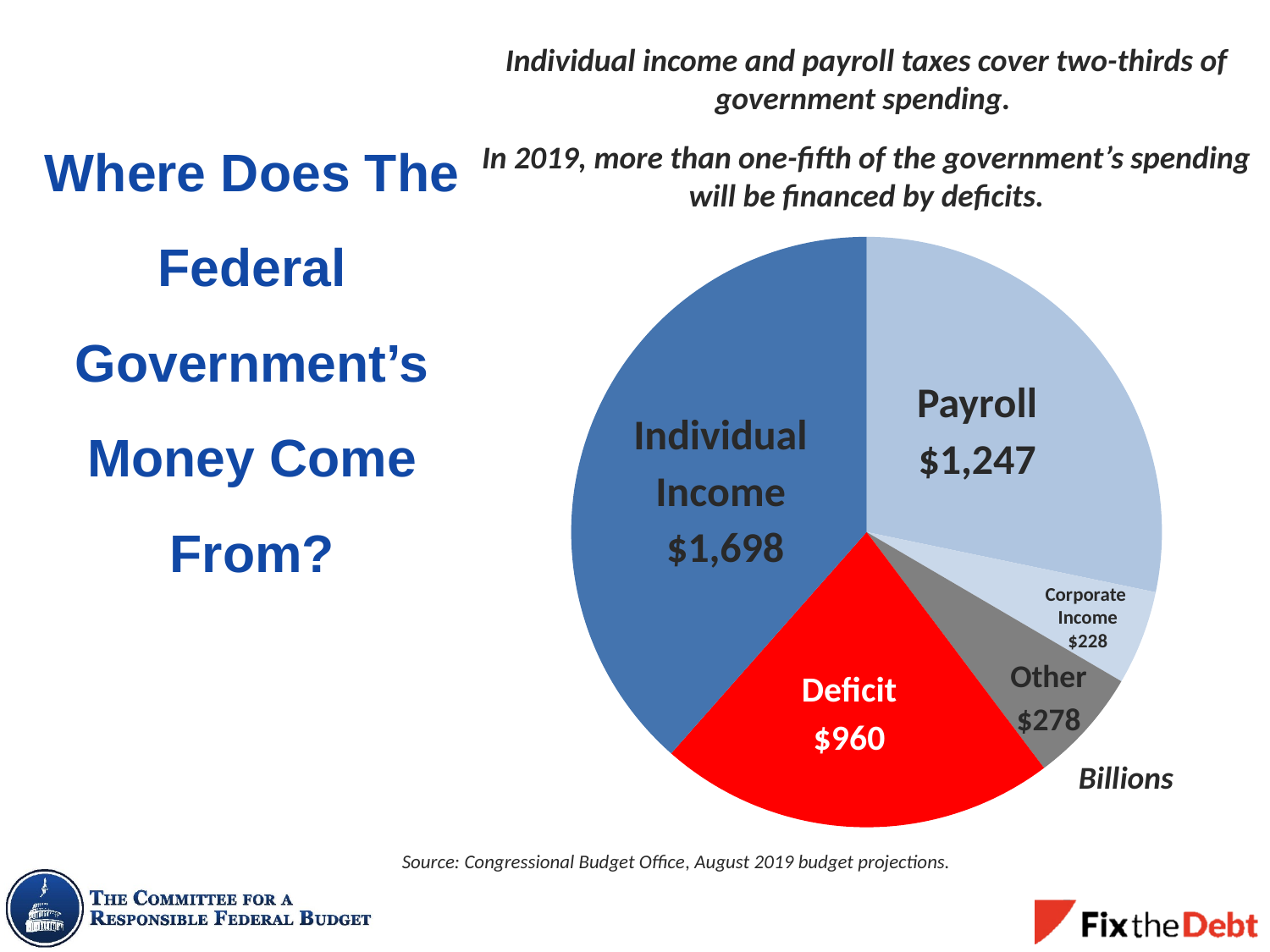
Which slice of the pie chart is the largest? Individual Income Which slice of the pie chart is the smallest? Corporate Income What is the value of the Deficit slice? $960 How many slices does the pie chart have? 5 What is the difference between the Individual Income and Payroll values? $451 What is the value of the Corporate Income slice? $228 Which is larger, the Other slice or the Corporate Income slice? Other In what units are the values on the pie chart expressed? Billions What is the difference between the Other and Corporate Income values? $50 What is the value of the Payroll slice? $1,247 What kind of chart is shown on the slide? Pie chart What is the value of the Individual Income slice? $1,698